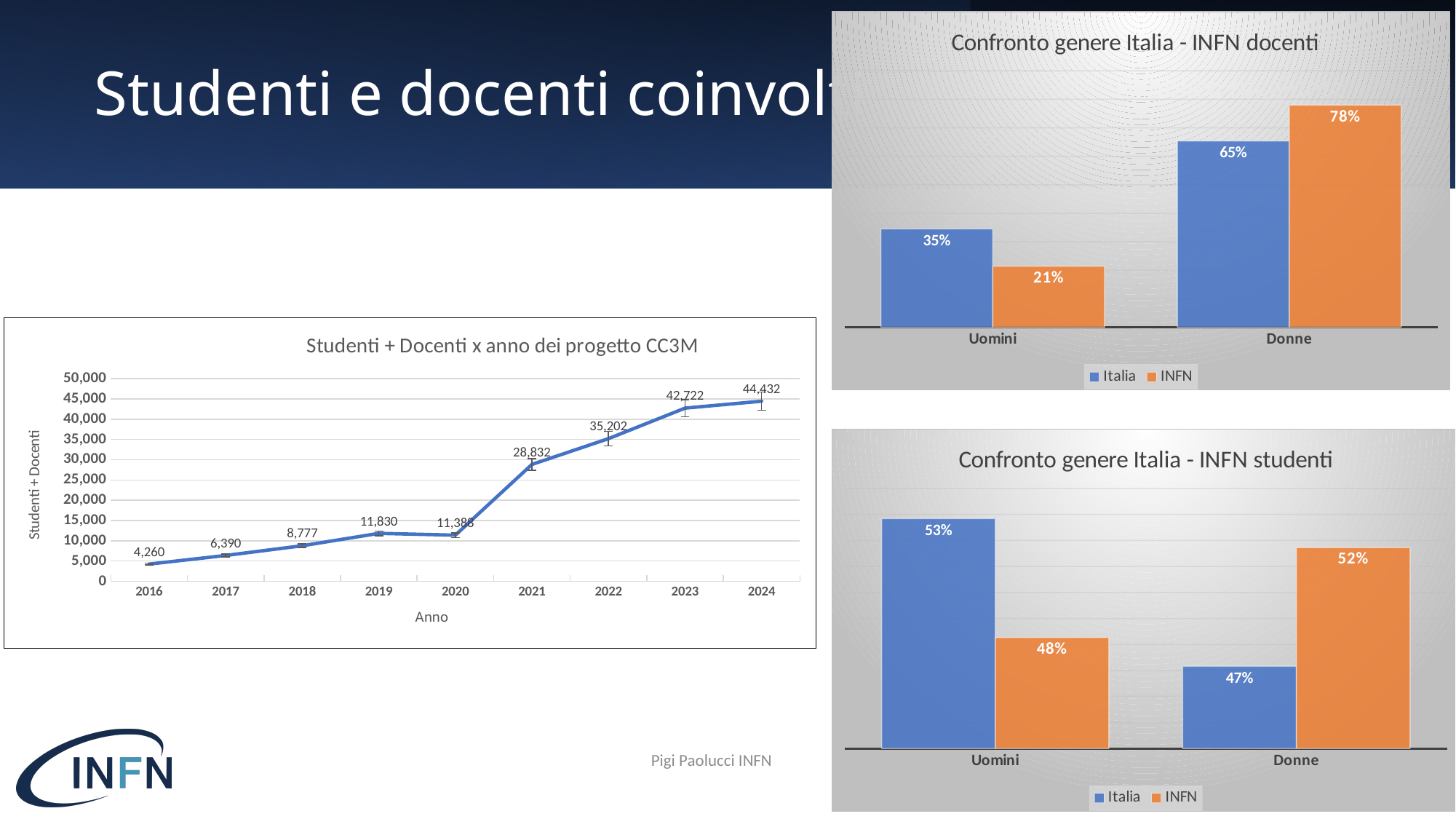
In the chart 'Studenti + Docenti x anno dei progetto CC3M', what is the difference between the 2024 value and the 2023 value? 1,710 In the chart 'Studenti + Docenti x anno dei progetto CC3M', how many years are plotted on the x axis? 9 In the chart 'Confronto genere Italia - INFN docenti', what is the INFN value for Donne? 78% In the chart 'Studenti + Docenti x anno dei progetto CC3M', is the value for 2020 greater or less than the value for 2019? less In the chart 'Confronto genere Italia - INFN studenti', what is the Italia value for Donne? 47% In the chart 'Studenti + Docenti x anno dei progetto CC3M', which year has the highest value? 2024 In the chart 'Confronto genere Italia - INFN docenti', what is the difference between the Italia and INFN values for Uomini? 14% In the chart 'Studenti + Docenti x anno dei progetto CC3M', what is the value for 2021? 28,832 In the chart 'Confronto genere Italia - INFN studenti', which is larger for Uomini: the Italia value or the INFN value? Italia In the chart 'Studenti + Docenti x anno dei progetto CC3M', which year has the lowest value? 2016 How many series does the legend list in the chart 'Confronto genere Italia - INFN studenti'? 2 What kind of chart is 'Studenti + Docenti x anno dei progetto CC3M'? Line chart